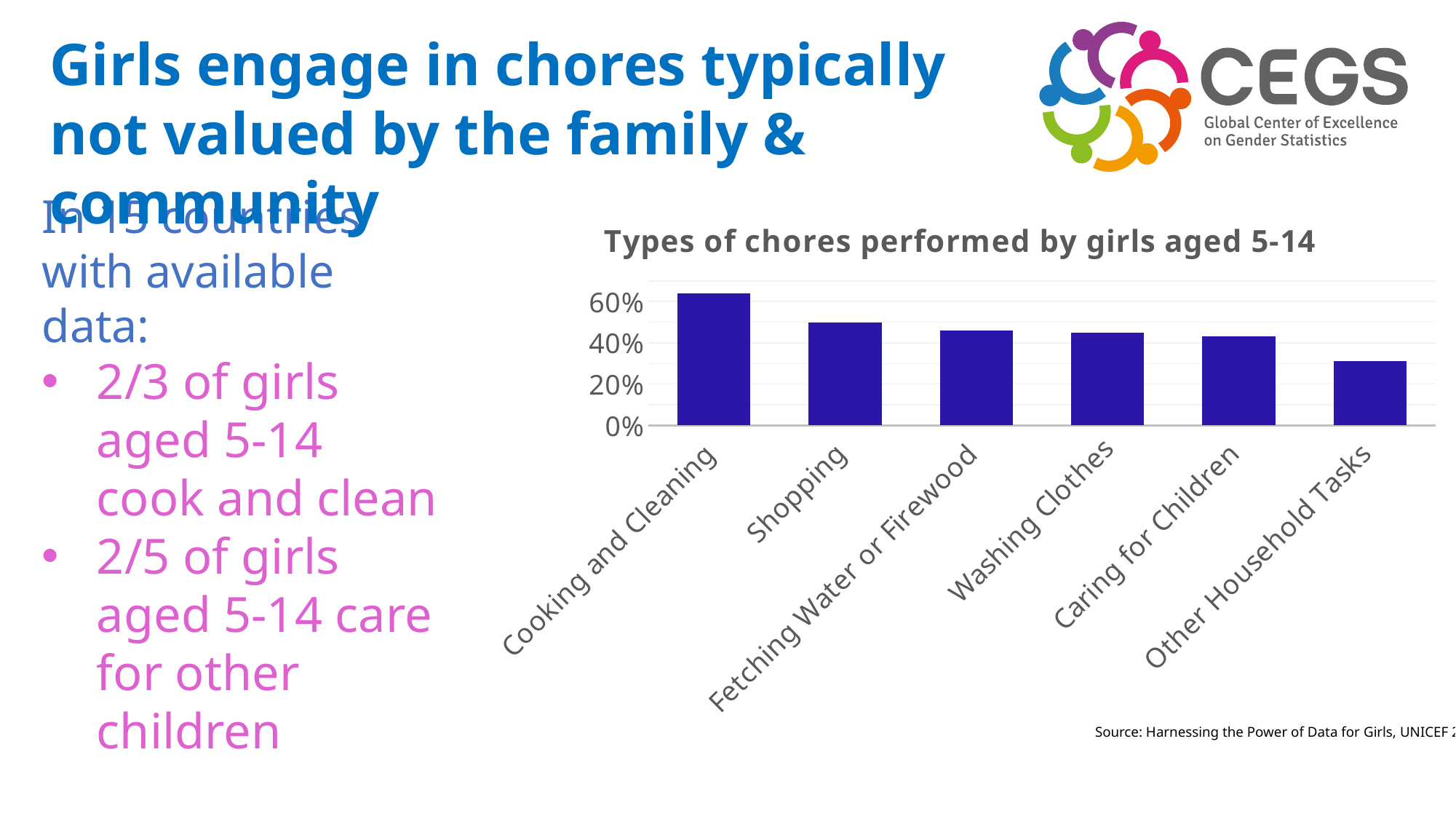
Is the value for Other Household Tasks greater or less than 40%? less Is the value for Caring for Children greater or less than 40%? greater What is the title of the chart? Types of chores performed by girls aged 5-14 Is the value for Other Household Tasks greater or less than 20%? greater Which chore has the lowest share of girls aged 5-14 performing it? Other Household Tasks What type of chart is shown on the slide? Bar chart How many chore categories are shown in the chart? 6 Which chore has the highest share of girls aged 5-14 performing it? Cooking and Cleaning Which is larger, the value for Washing Clothes or the value for Other Household Tasks? Washing Clothes Do the bar values rise or fall moving from left to right across the chart? Fall Which is larger, the value for Shopping or the value for Caring for Children? Shopping